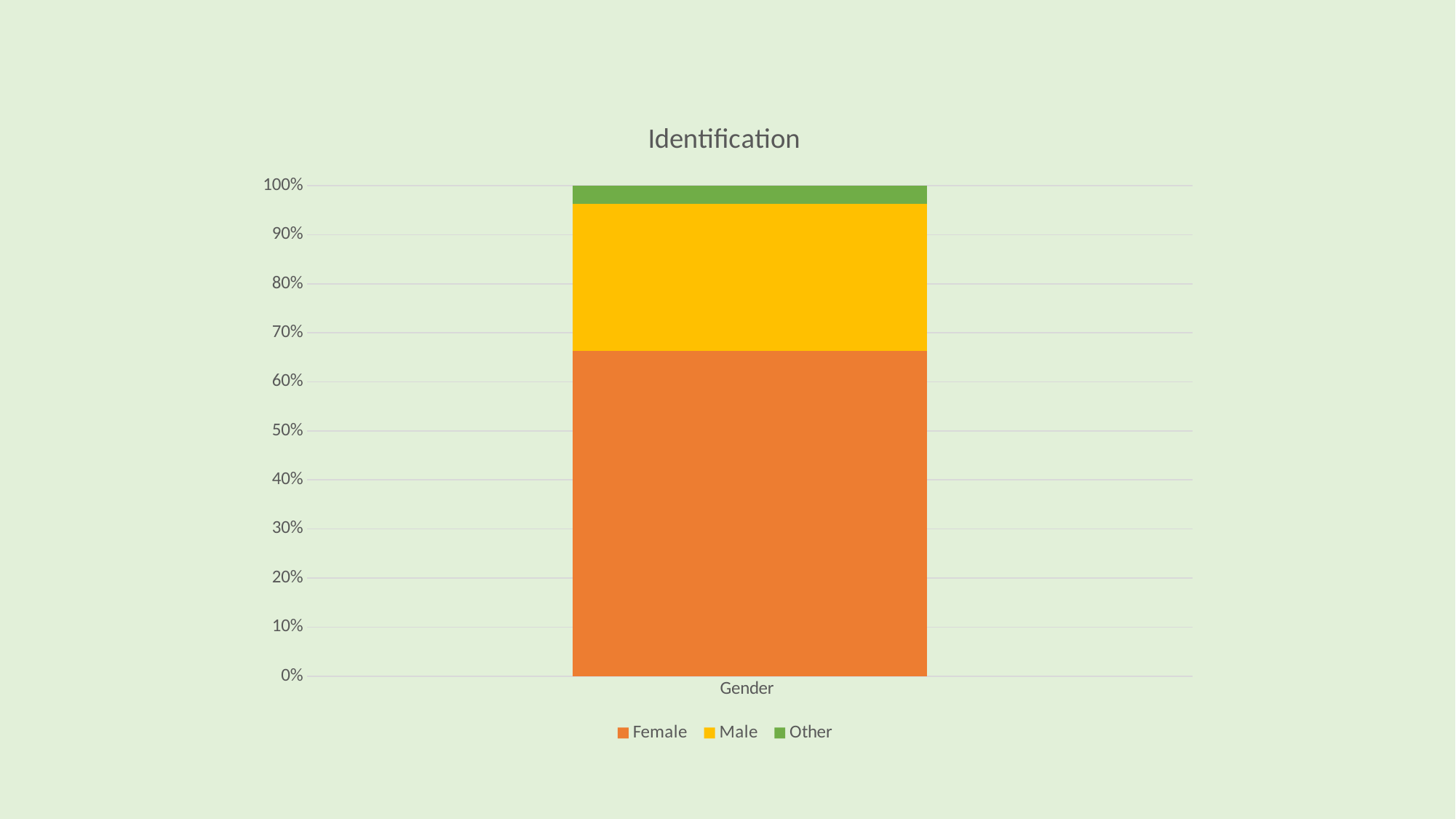
Is the Male share of the Gender bar greater or less than 40%? less Is the Female share of the Gender bar greater or less than 50%? greater Which is larger in the Gender bar, the Male share or the Other share? Male Which series takes up the smallest share of the Gender bar? Other How many series does the legend list? 3 How many categories are shown on the x axis? 1 Which series takes up the largest share of the Gender bar? Female What is the label of the category on the x axis? Gender Which series are listed in the legend? Female, Male, Other What is the title of the chart? Identification Is the Other share of the Gender bar greater or less than 10%? less What kind of chart is shown on the slide? stacked bar chart